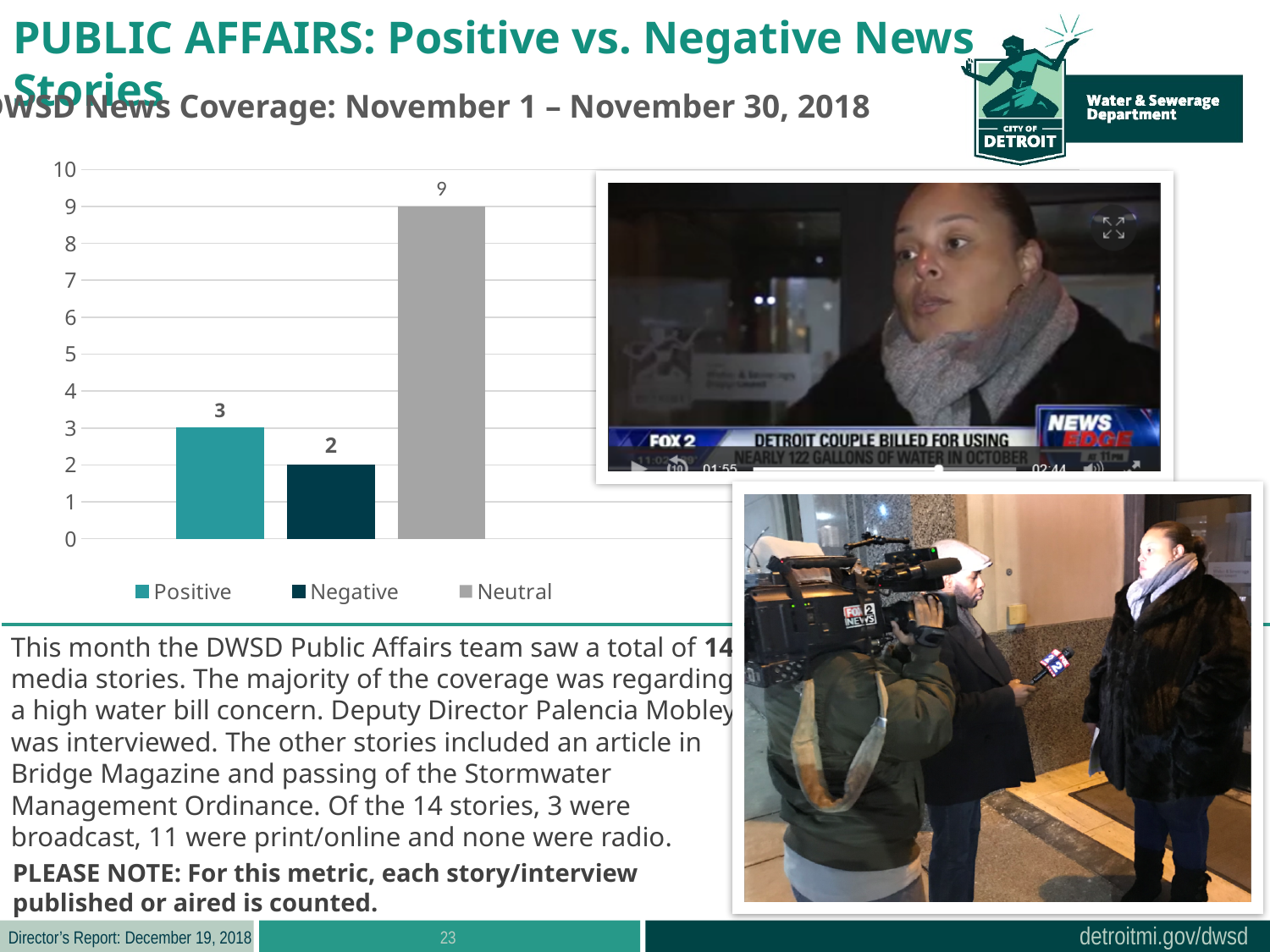
Which category has the lowest value? Negative What is the total of the Positive, Negative and Neutral values? 14 How many series does the legend list? 3 What is the value for Negative news stories? 2 Which is larger, the value for Positive or the value for Negative? Positive What is the difference between the Positive and Negative values? 1 What is the value for Positive news stories? 3 What is the difference between the Neutral and Positive values? 6 What is the value for Neutral news stories? 9 What kind of chart is shown on the slide? Bar chart Is the value for Neutral greater or less than 5? greater Which category has the highest value? Neutral